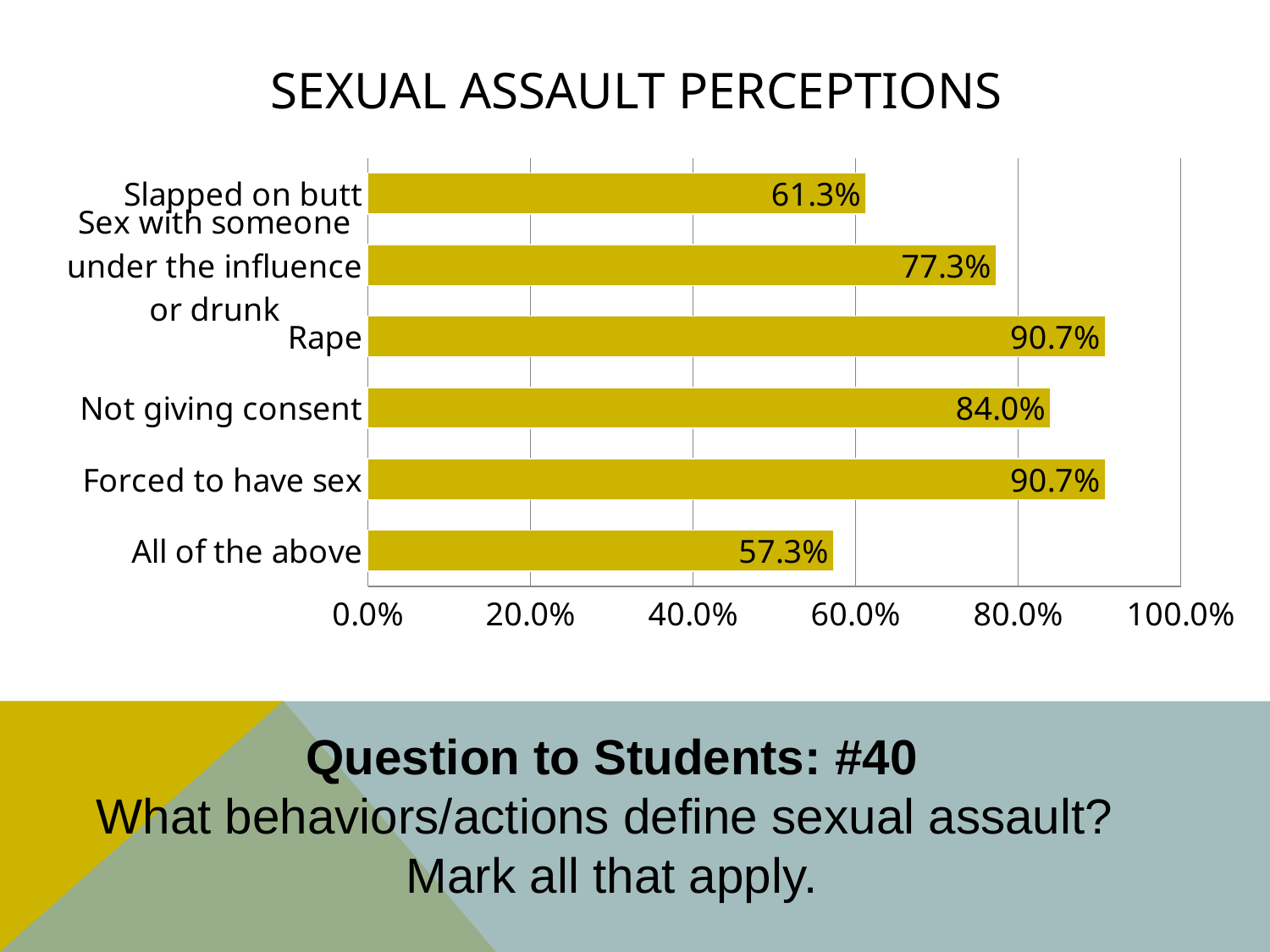
How many categories are shown in the chart? 6 What is the value shown for "Sex with someone under the influence or drunk"? 77.3% What percentage of students marked "Slapped on butt" as defining sexual assault? 61.3% What is the difference between the values for "Rape" and "All of the above"? 33.4% What is the value shown for "Not giving consent"? 84.0% What is the difference between the values for "Not giving consent" and "Slapped on butt"? 22.7% Which has a larger value, "Slapped on butt" or "All of the above"? Slapped on butt Which has a larger value, "Not giving consent" or "Sex with someone under the influence or drunk"? Not giving consent Which category has the lowest value in the chart? All of the above What is the value shown for "Forced to have sex"? 90.7% What is the title of the chart? SEXUAL ASSAULT PERCEPTIONS What type of chart is shown on the slide? Bar chart